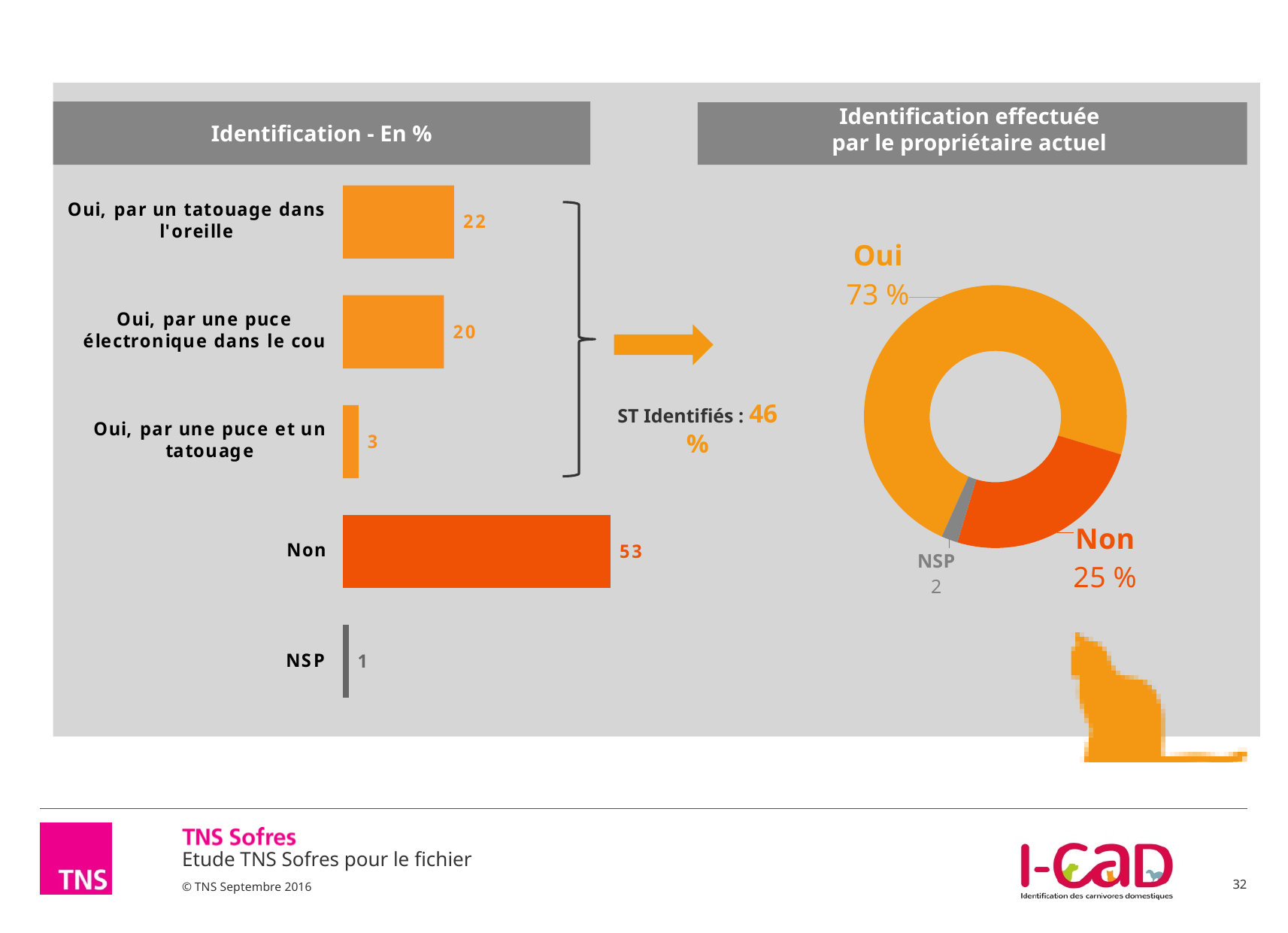
In the 'Identification - En %' chart, what is the difference between the values for 'Non' and 'Oui, par un tatouage dans l'oreille'? 31 In the 'Identification - En %' chart, what is the value for 'Oui, par une puce électronique dans le cou'? 20 In the 'Identification - En %' chart, what is the 'ST Identifiés' total shown next to the bracket? 46 % What kind of chart is 'Identification effectuée par le propriétaire actuel'? Donut chart In the 'Identification - En %' chart, what is the value for 'Oui, par un tatouage dans l'oreille'? 22 In the 'Identification - En %' chart, what is the value for 'Non'? 53 What kind of chart is 'Identification - En %'? Bar chart In the 'Identification - En %' chart, how many categories are shown? 5 In the 'Identification - En %' chart, which category has the highest value? Non In the 'Identification - En %' chart, which category has the lowest value? NSP In the 'Identification effectuée par le propriétaire actuel' chart, which is larger, 'Non' or 'NSP'? Non In the 'Identification effectuée par le propriétaire actuel' chart, what is the share for 'Oui'? 73 %